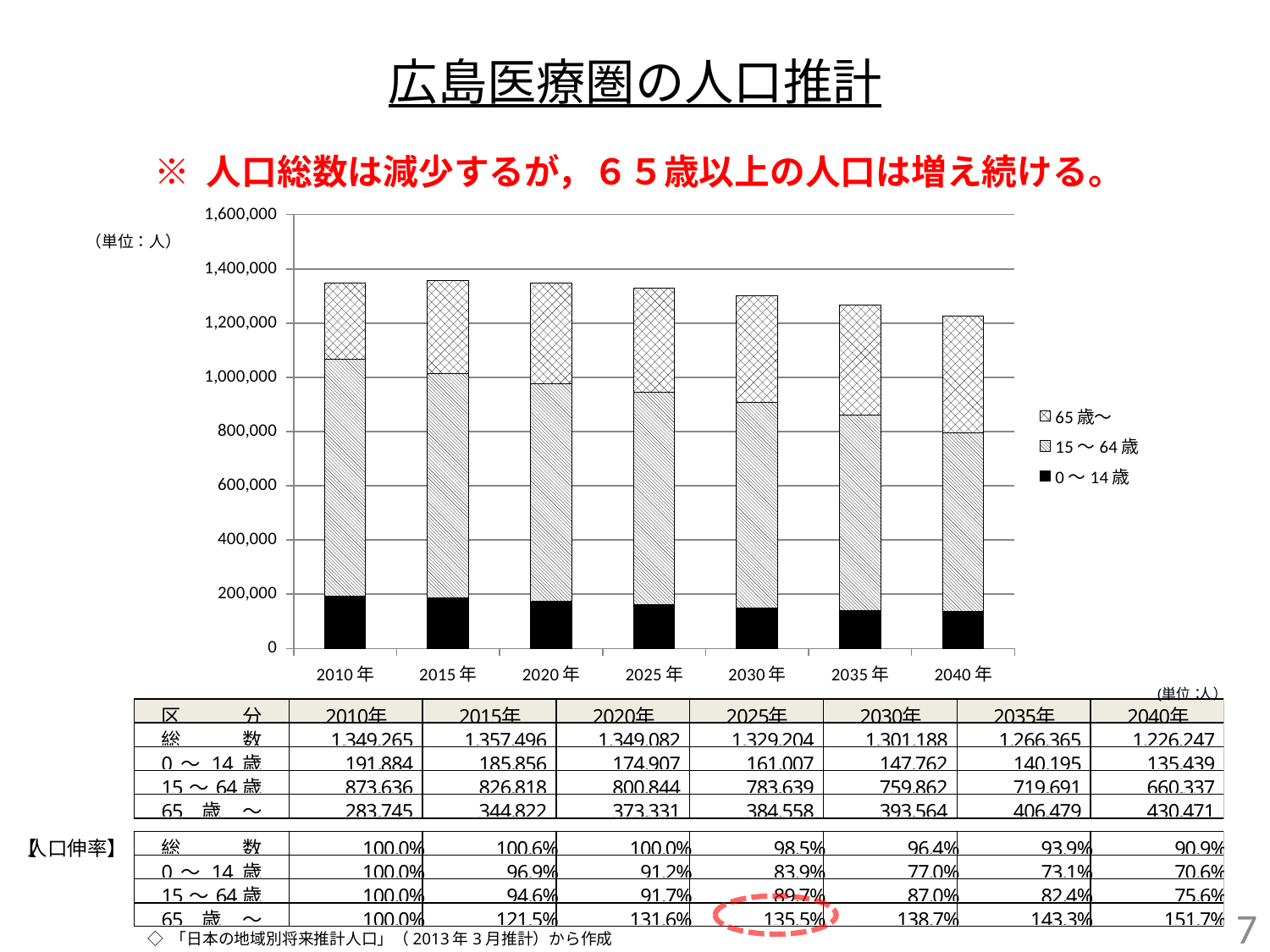
In which year is the total population (総数) the lowest? 2040年 According to the table, what is the population aged 15～64歳 in 2025年? 783,639 According to the table below the chart, what is the total population (総数) in 2010年? 1,349,265 How many series does the chart legend list? 3 According to the table, what is the population aged 65歳～ in 2040年? 430,471 By how much does the 65歳～ population in 2040年 exceed that in 2010年? 146,726 Is the total height of the 2040年 bar greater or less than 1,400,000? less In which year is the 65歳～ population the highest? 2040年 What kind of chart is shown on the slide? Stacked bar chart How many years (categories) are plotted along the x axis of the chart? 7 In 2010年, which is larger: the 15～64歳 population or the 65歳～ population? 15～64歳 Does the total population (total bar height) rise or fall from 2015年 to 2040年? Fall